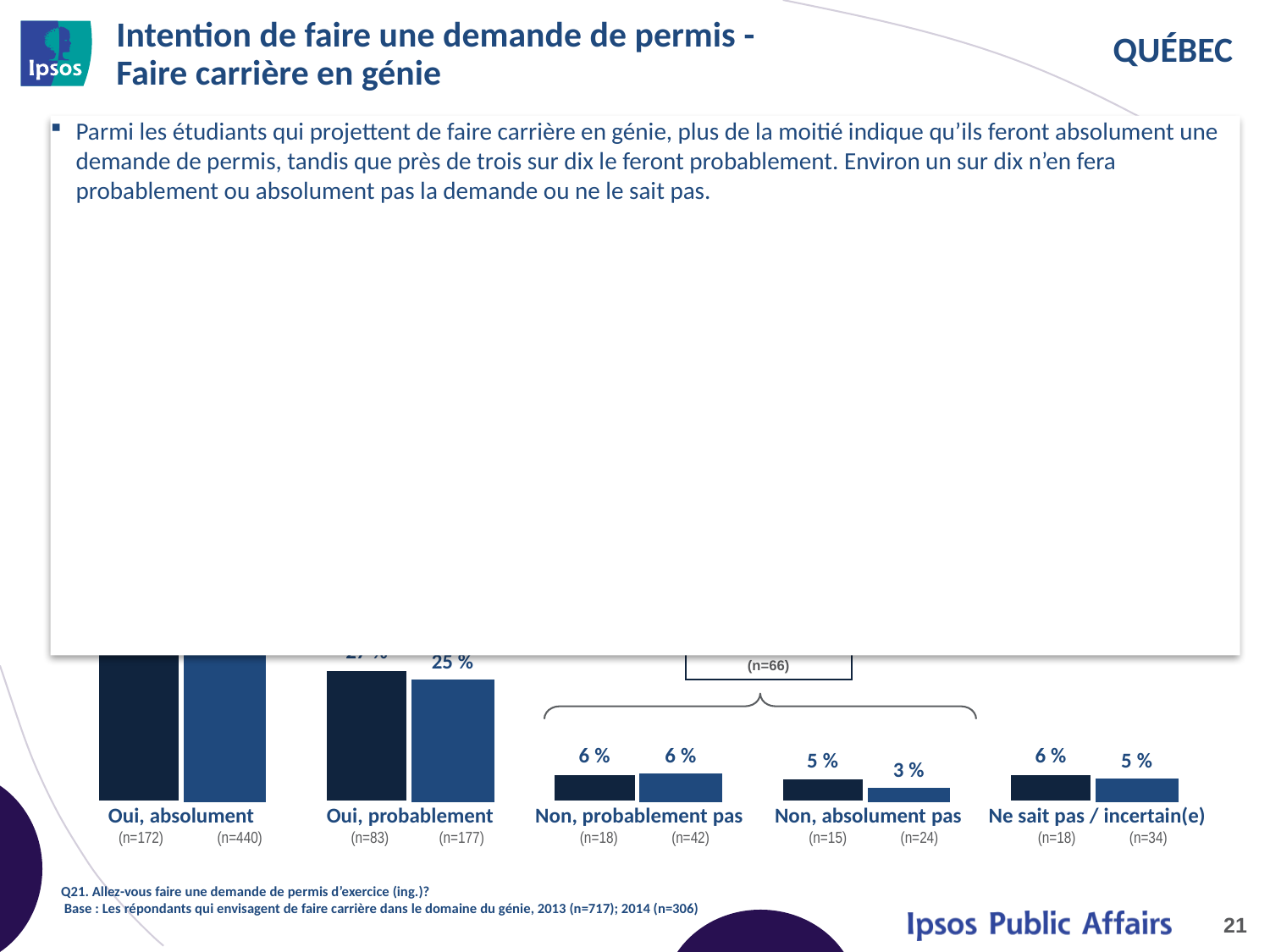
How many response categories are shown along the x axis of the chart? 5 What sample size (n) is printed under the dark navy bar for "Oui, absolument"? n=172 What is the value of the lighter blue bar for "Non, absolument pas"? 3 % What is the value of the dark navy bar for "Non, probablement pas"? 6 % What is the value of the lighter blue bar for "Ne sait pas / incertain(e)"? 5 % For "Ne sait pas / incertain(e)", which bar is larger, the dark navy bar or the lighter blue bar? the dark navy bar Which category has the tallest bars in the chart? Oui, absolument What kind of chart is shown on the slide? bar chart What is the value of the lighter blue bar for "Oui, probablement"? 25 % What is the value of the dark navy bar for "Non, absolument pas"? 5 % What is the difference between the dark navy bar and the lighter blue bar for "Non, absolument pas"? 2 % Which bar has the lowest printed value in the chart? the lighter blue bar for Non, absolument pas (3 %)